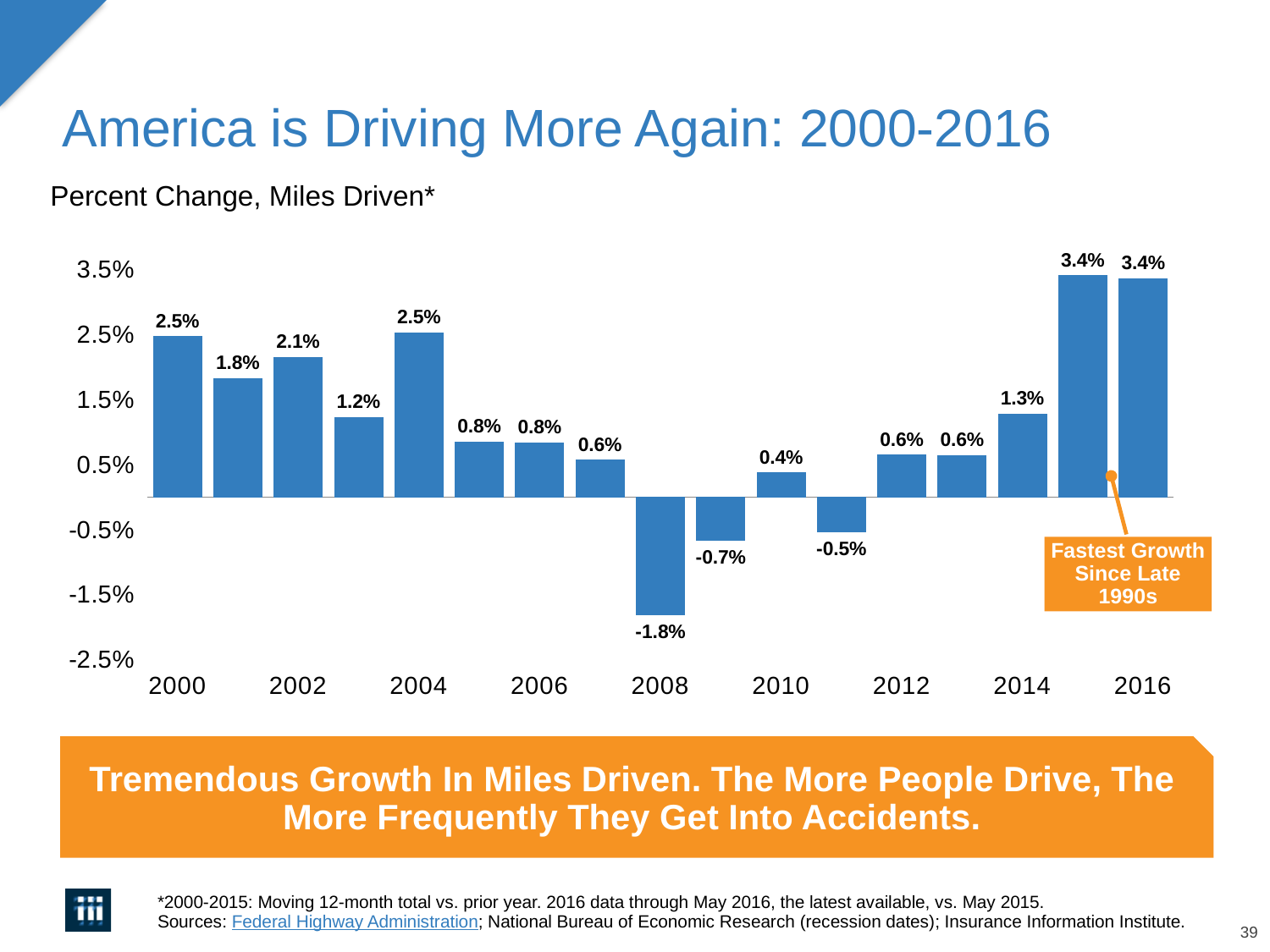
What is the percent change in miles driven for 2010? 0.4% Which year has a larger percent change in miles driven, 2004 or 2006? 2004 What does the orange callout on the chart say about the 2015-2016 growth? Fastest Growth Since Late 1990s What is the difference between the percent change in 2016 and in 2014? 2.1% What is the percent change in miles driven for 2014? 1.3% What is the percent change in miles driven for 2016? 3.4% What is the percent change in miles driven for 2000? 2.5% What is the percent change in miles driven for 2008? -1.8% What is the highest percent change value shown on the chart? 3.4% What type of chart is shown on the slide? Bar chart Which year has the lowest percent change in miles driven? 2008 How many bars are plotted on the chart? 17